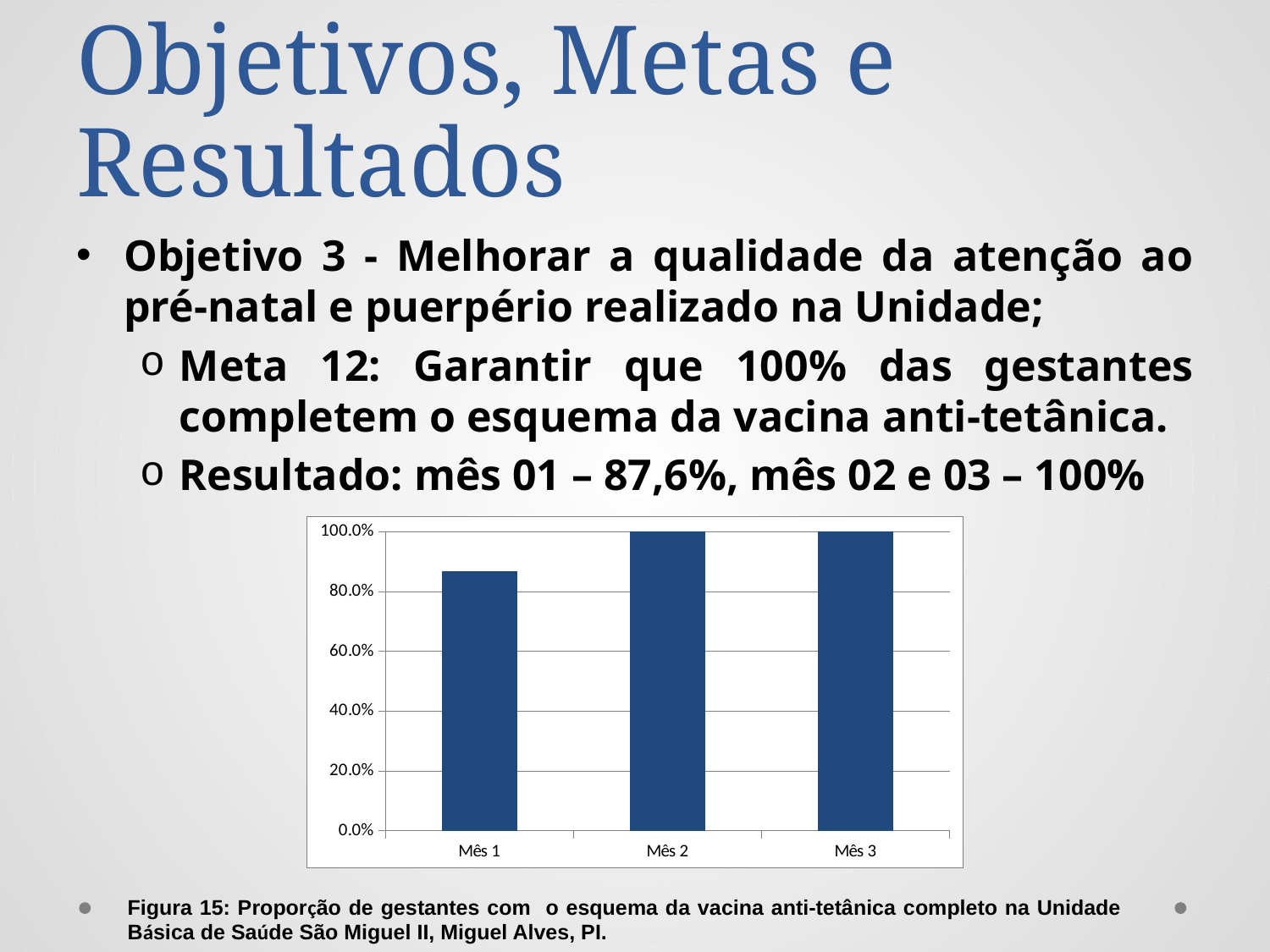
What is the highest tick value shown on the y axis of the chart? 100.0% Is the value for Mês 1 greater or less than 80.0%? greater Do the values rise or fall from Mês 1 to Mês 2? rise According to the slide, what was the result for mês 01? 87,6% What is the value for Mês 2 in the chart? 100.0% What is the value for Mês 3 in the chart? 100.0% Is the value for Mês 1 greater or less than 100.0%? less How many categories (months) are shown on the x axis of the chart? 3 What figure number is given in the caption below the chart? Figura 15 Which month has the lowest value in the chart? Mês 1 Which is larger, the value for Mês 1 or the value for Mês 2? Mês 2 What kind of chart is shown on the slide? bar chart